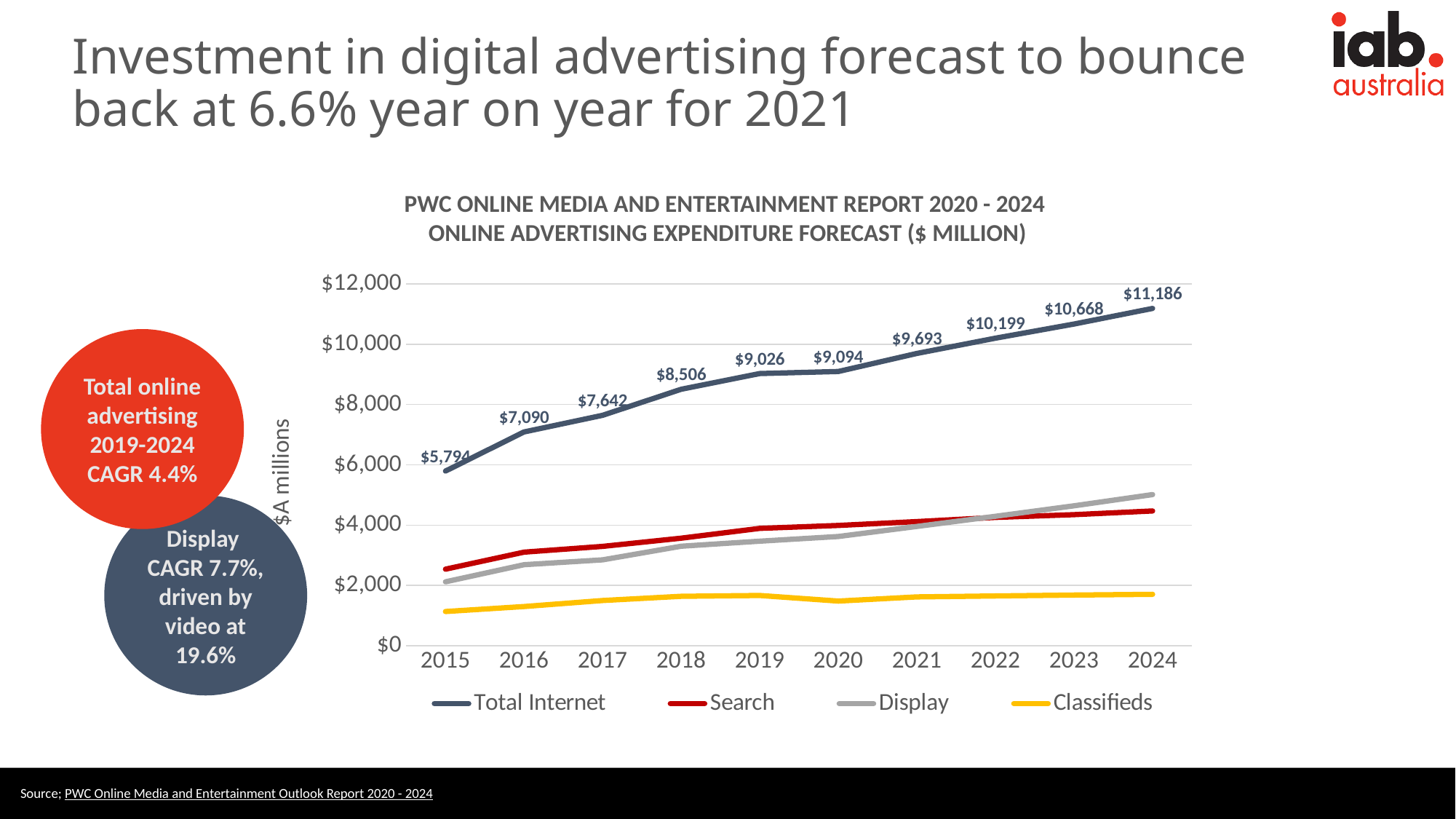
Is the value for Classifieds in 2015 greater or less than $2,000? less How many years are shown on the x axis? 10 What is the difference between the Total Internet values for 2024 and 2023? $518 In which year is the Total Internet series highest? 2024 What kind of chart is shown on the slide? Line chart What is the Total Internet value for 2015? $5,794 How many series does the legend list? 4 Which is larger, the Total Internet value for 2019 or for 2020? 2020 What is the Total Internet value for 2020? $9,094 Is the value for Search in 2024 greater or less than $4,000? greater What is the Total Internet value for 2024? $11,186 In which year is the Total Internet series lowest? 2015